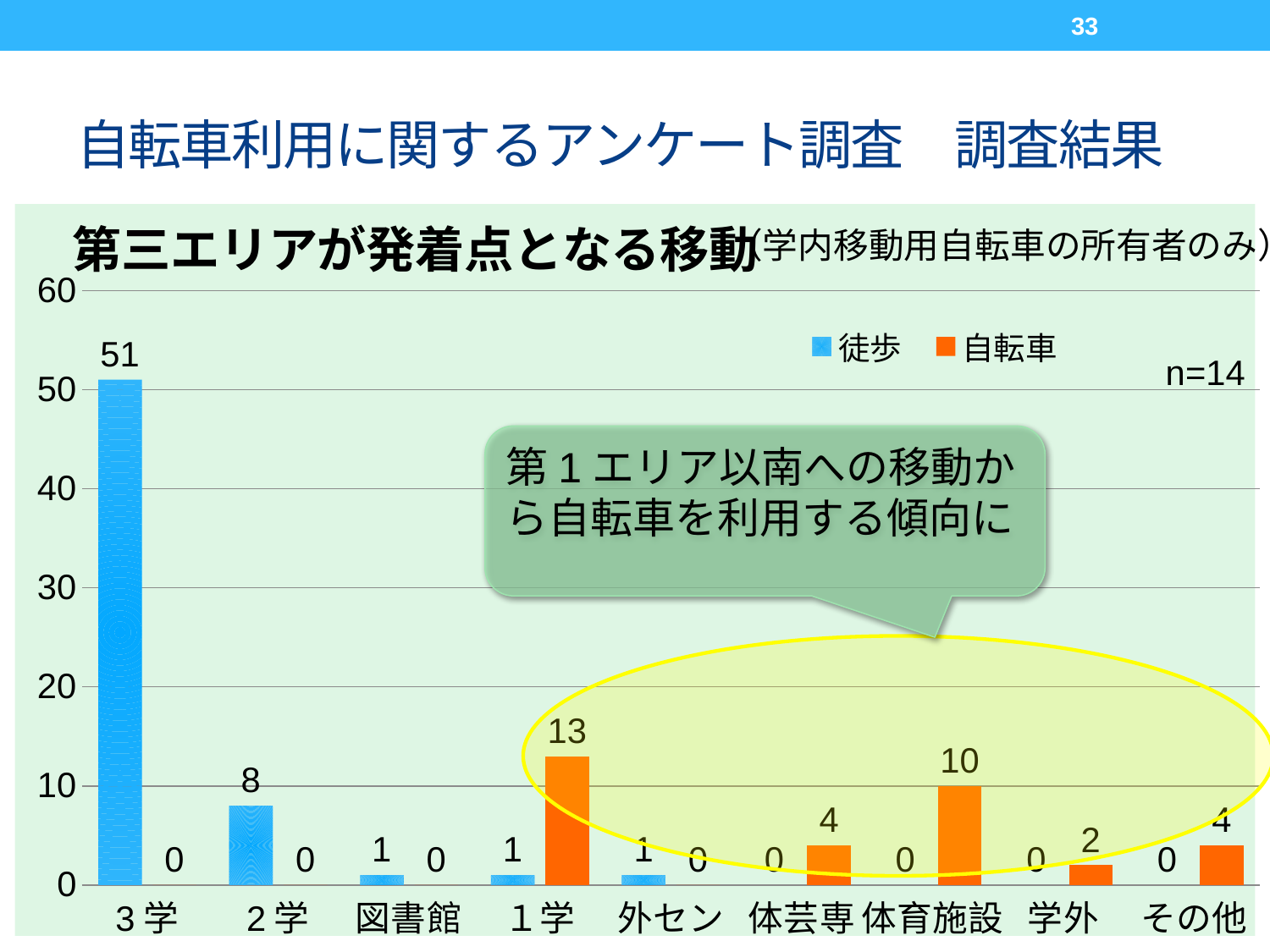
What kind of chart is shown? bar chart Which is larger, the 自転車 value for 体芸専 or for 学外? 体芸専 Which category has the highest 徒歩 value? 3学 What is the sample size (n) shown on the chart? n=14 How many series does the legend list? 2 What is the 徒歩 value for 3学? 51 How many categories are shown on the x axis? 9 What is the 自転車 value for 1学? 13 What is the 自転車 value for 体育施設? 10 What is the difference between the 自転車 values for 1学 and 体育施設? 3 What is the 徒歩 value for 2学? 8 Which category has the highest 自転車 value? 1学